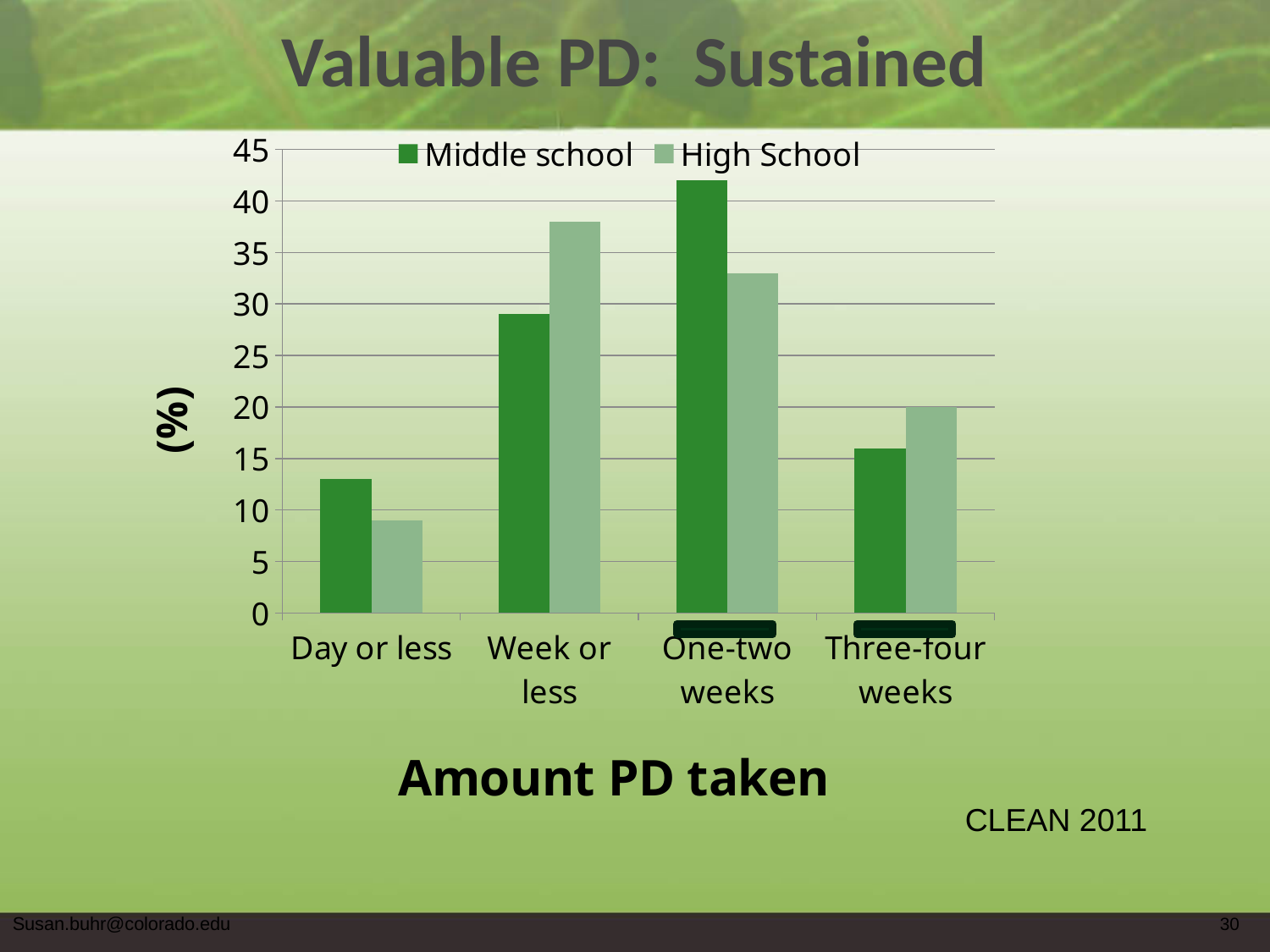
What kind of chart is shown on the slide? bar chart For which category is the High School value lowest? Day or less For which category is the High School value highest? Week or less How many categories are shown on the x axis? 4 For the Three-four weeks category, which series has the larger value, Middle school or High School? High School Is the Middle school value for One-two weeks greater or less than 40? greater For the Day or less category, which series has the larger value, Middle school or High School? Middle school What is the title of the x axis? Amount PD taken For the Week or less category, which series has the larger value, Middle school or High School? High School Is the High School value for Day or less greater or less than 10? less How many series does the legend list? 2 For which category is the Middle school value highest? One-two weeks